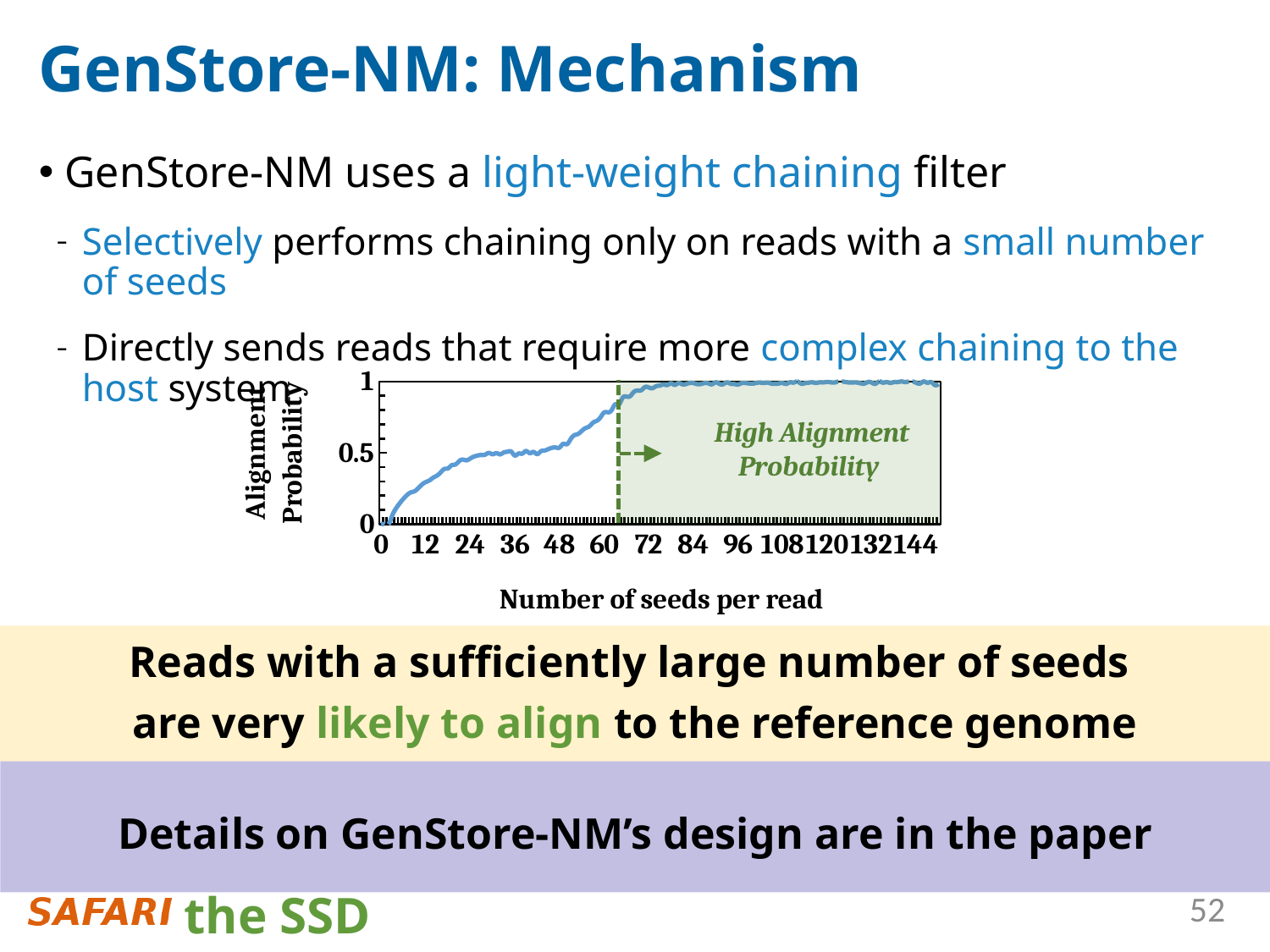
What is the largest value shown on the x axis of the chart? 144 What is the highest tick value shown on the y axis of the chart? 1 What is the label of the x axis of the chart? Number of seeds per read What kind of chart is shown on the slide? line chart Is the alignment probability at 132 seeds per read greater or less than 0.5? greater Which of the two has a higher alignment probability: 12 seeds per read or 84 seeds per read? 84 seeds per read Is the alignment probability at 12 seeds per read greater or less than 0.5? less How many tick labels are shown on the x axis of the chart? 13 Does the alignment probability rise or fall as the number of seeds per read increases? rise What is the label of the y axis of the chart? Alignment Probability Is the alignment probability at 96 seeds per read greater or less than 0.5? greater